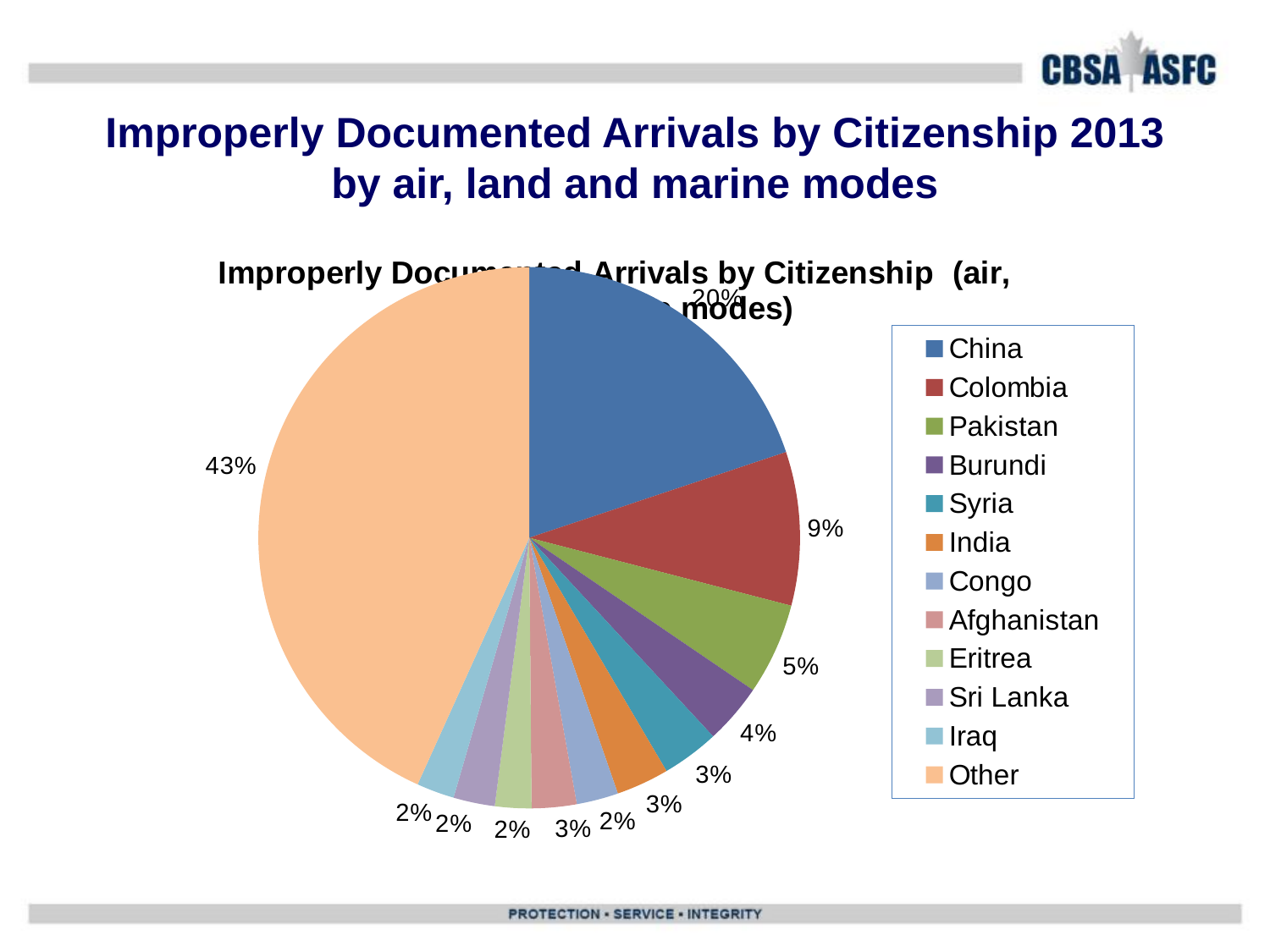
What share of the pie does Other account for? 43% What is the difference in percentage points between the Pakistan slice and the Burundi slice? 1 What share of the pie does Burundi account for? 4% Which named country (excluding Other) has the largest slice of the pie? China What colour is the Other slice in the pie chart? light orange Which is larger, the slice for Colombia or the slice for Pakistan? Colombia Which category has the largest slice of the pie? Other What share of the pie does Colombia account for? 9% What kind of chart is shown on the slide? pie chart What share of the pie does Pakistan account for? 5% How many categories does the legend of the pie chart list? 12 What is the difference in percentage points between the Other slice and the Colombia slice? 34